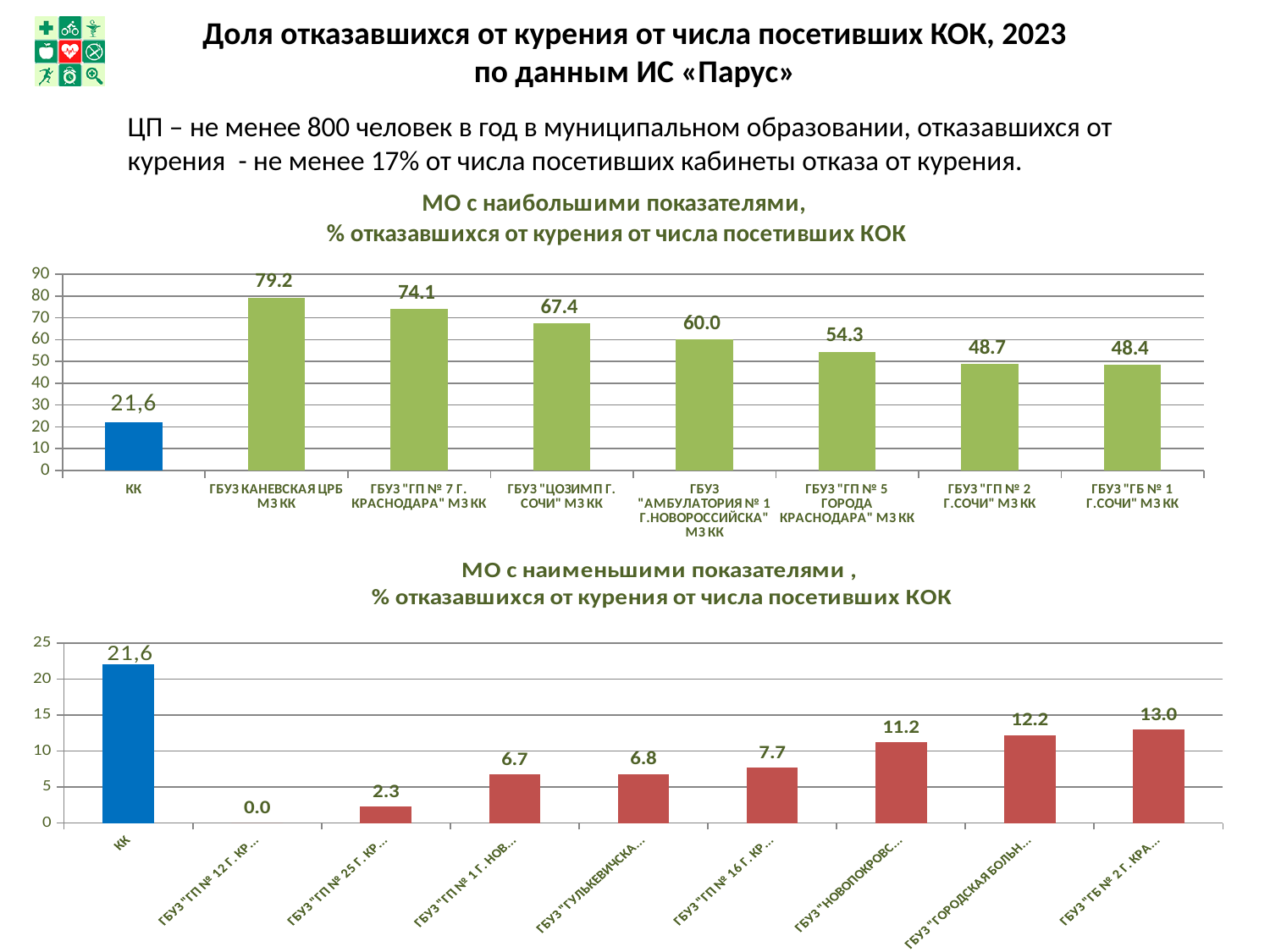
In the bottom chart (МО с наименьшими показателями), how many categories are shown? 9 In the top chart (МО с наибольшими показателями), which category has the highest value? ГБУЗ КАНЕВСКАЯ ЦРБ МЗ КК In the top chart (МО с наибольшими показателями), what is the value for ГБУЗ "ГП № 5 ГОРОДА КРАСНОДАРА" МЗ КК? 54.3 In the top chart (МО с наибольшими показателями), is the value for ГБУЗ "ГП № 2 Г.СОЧИ" МЗ КК greater or less than 50? less In the bottom chart (МО с наименьшими показателями), which category has the highest value? КК In the top chart (МО с наибольшими показателями), how many categories are shown? 8 In the top chart (МО с наибольшими показателями), what is the value for ГБУЗ КАНЕВСКАЯ ЦРБ МЗ КК? 79.2 What type of chart is the bottom chart (МО с наименьшими показателями)? bar chart In the bottom chart (МО с наименьшими показателями), what is the value for КК? 21,6 In the top chart (МО с наибольшими показателями), which category has the lowest value? КК In the top chart (МО с наибольшими показателями), what is the difference between ГБУЗ "ГП № 7 Г. КРАСНОДАРА" МЗ КК and ГБУЗ "ЦОЗИМП Г. СОЧИ" МЗ КК? 6.7 In the bottom chart (МО с наименьшими показателями), what is the lowest value shown? 0.0